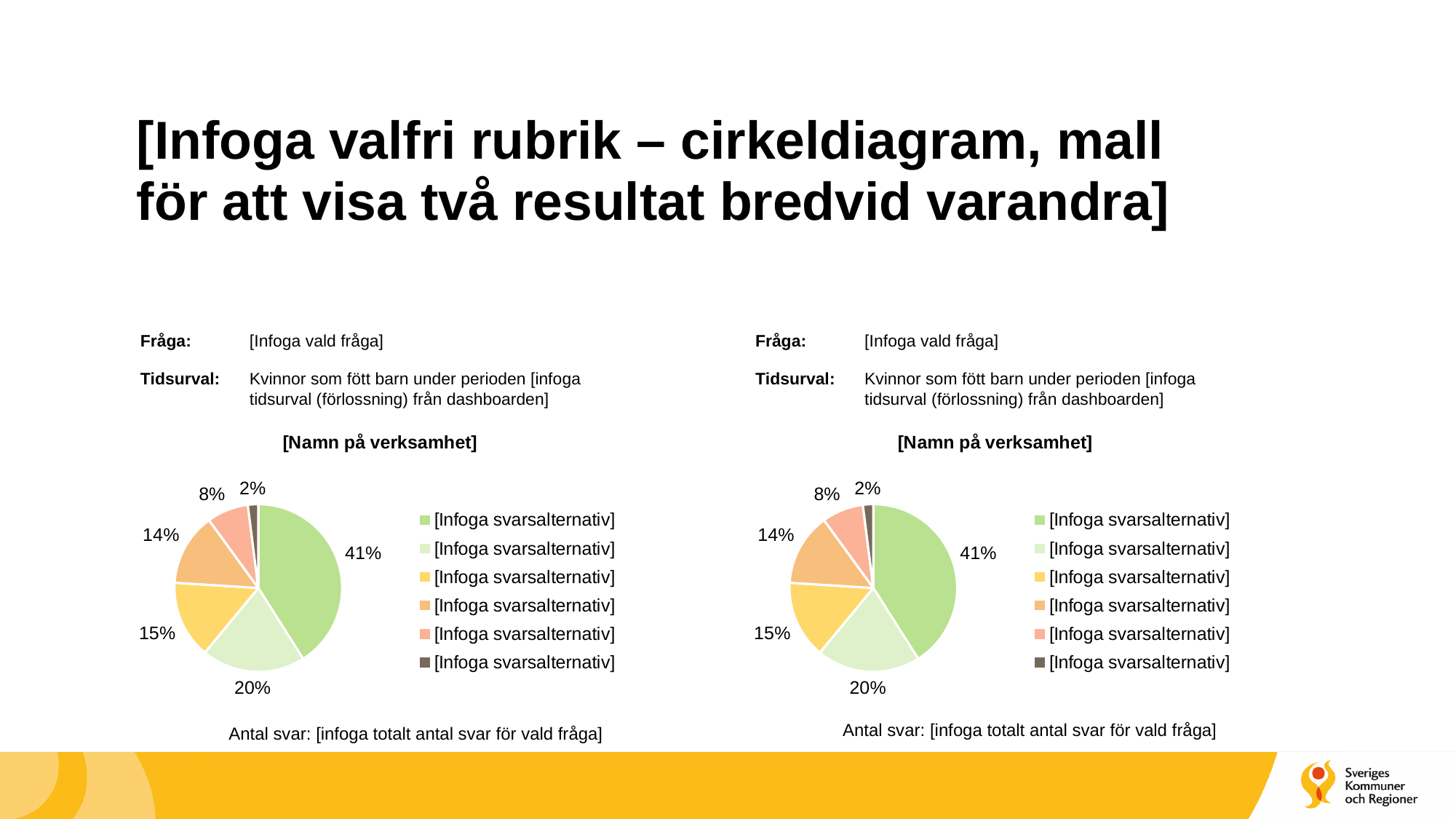
What kind of chart is the left chart on the slide? pie chart How many slices does the left pie chart have? 6 What text is shown below the left pie chart? Antal svar: [infoga totalt antal svar för vald fråga] In the left pie chart, what is the value of the pink (salmon) slice? 8% What is the title shown above the right pie chart? [Namn på verksamhet] In the right pie chart, what is the value of the smallest slice? 2% In the left pie chart, what share does the light green slice represent? 20% How many entries does the legend of the right pie chart list? 6 In the right pie chart, what share does the dark green slice represent? 41% In the right pie chart, which is larger: the yellow slice or the orange slice? the yellow slice (15%) In the left pie chart, what is the difference between the largest slice (41%) and the smallest slice (2%)? 39 percentage points In the left pie chart, what is the value of the largest slice? 41%